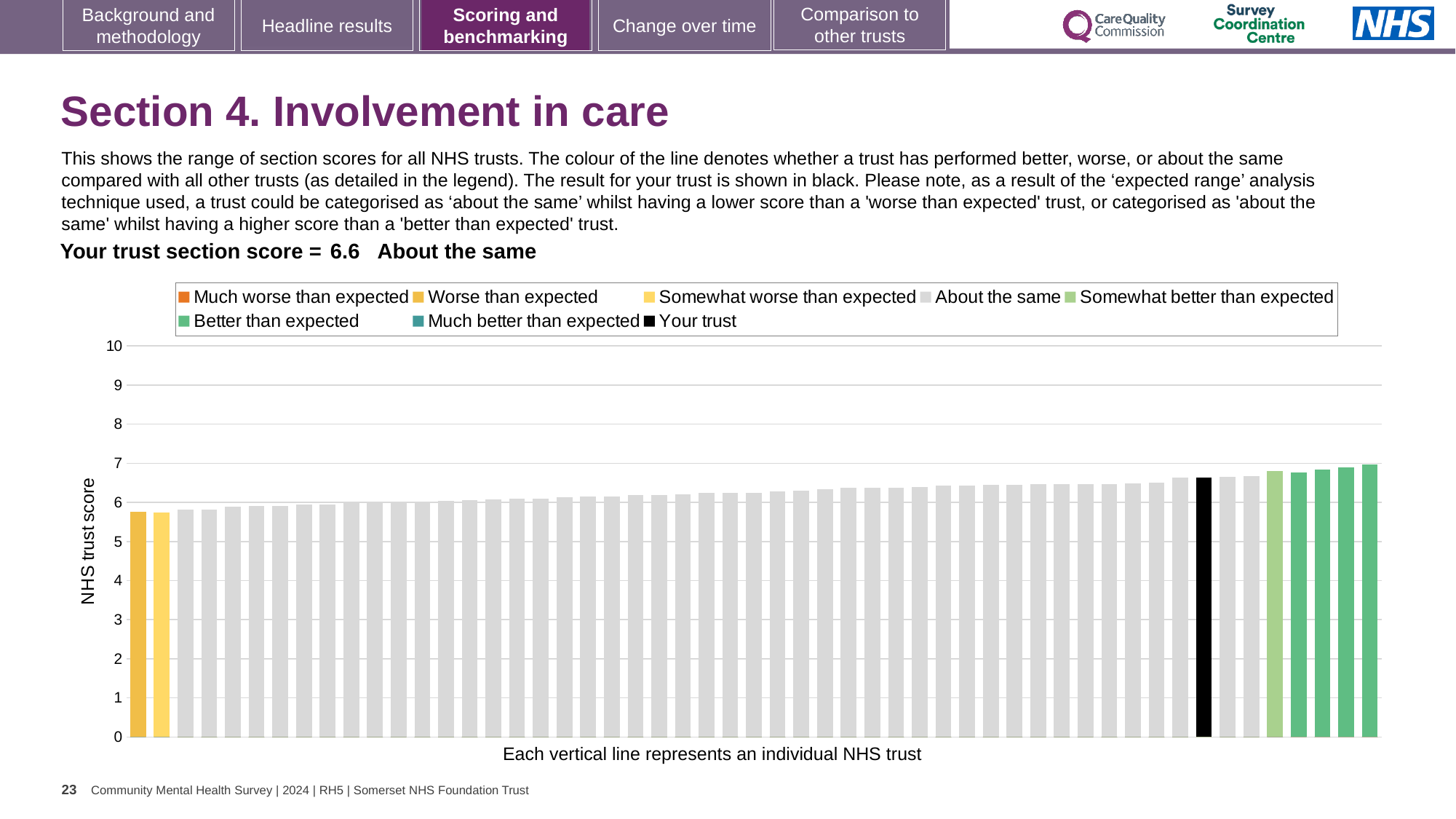
Is the value for your trust greater or less than 6? greater Do the bar values rise or fall from left to right along the x axis? rise Which category is your trust placed in for this section? About the same Is the value of the lowest bar greater or less than 5? greater How many bars are coloured as 'Worse than expected'? 1 What type of chart is shown on the slide? bar chart Is the value for your trust greater or less than 7? less How many entries does the chart legend list? 8 What is the label on the y axis of the chart? NHS trust score What colour is the bar representing your trust? black What is the section score for your trust shown on the slide? 6.6